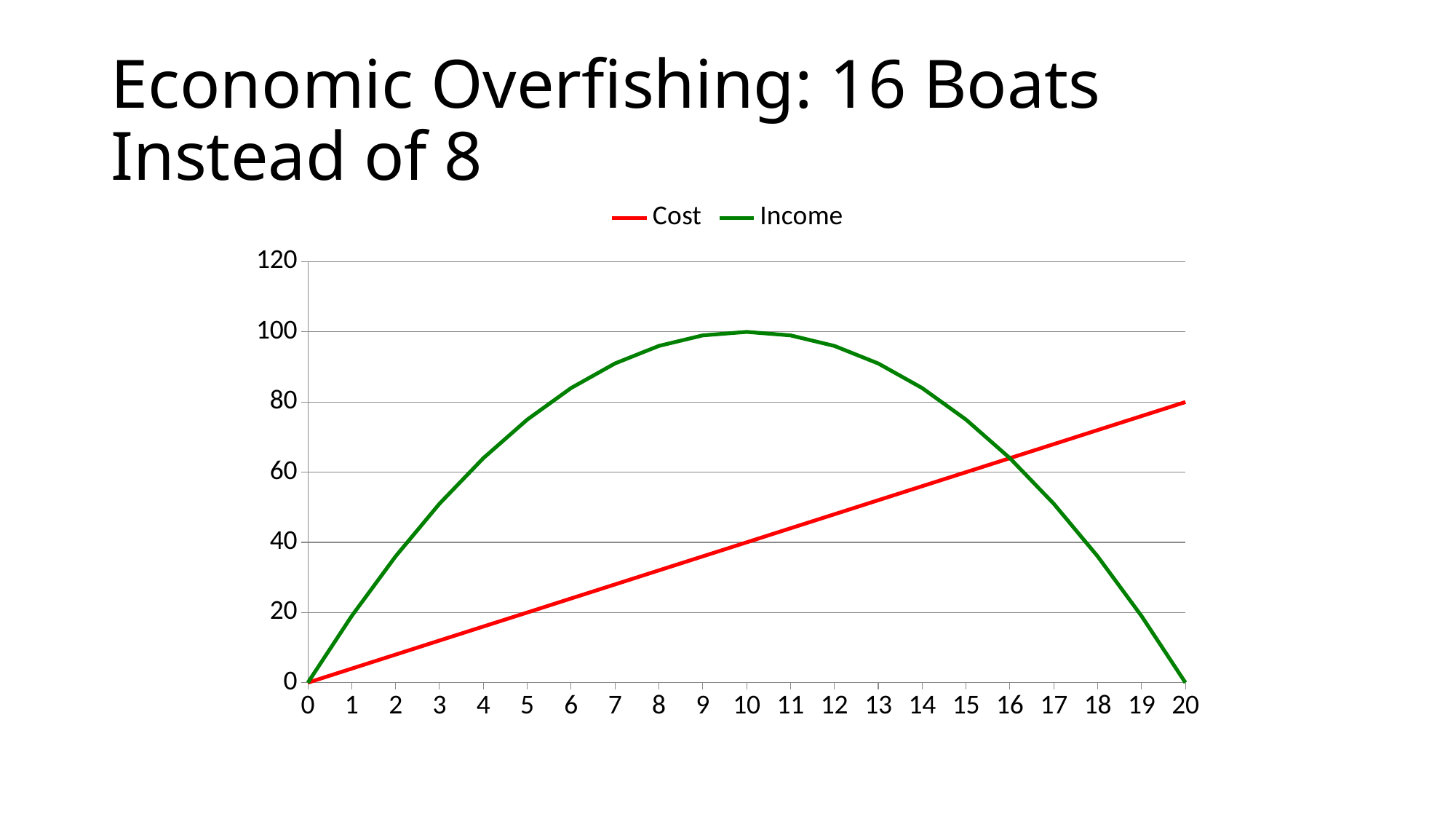
What is the value of Income at 10 on the x axis? 100 Is the value of Income at 5 greater or less than 60? greater How many series does the legend list? 2 What are the two series named in the legend? Cost and Income At 18 on the x axis, which is larger, Cost or Income? Cost At which x-axis value does Income reach its highest point? 10 What is the value of Cost at 20 on the x axis? 80 What kind of chart is shown on the slide? line chart At 5 on the x axis, which is larger, Cost or Income? Income What is the value of Cost at 10 on the x axis? 40 Is the value of Income at 18 greater or less than 40? less Does the Cost line rise or fall as the x axis increases? rise